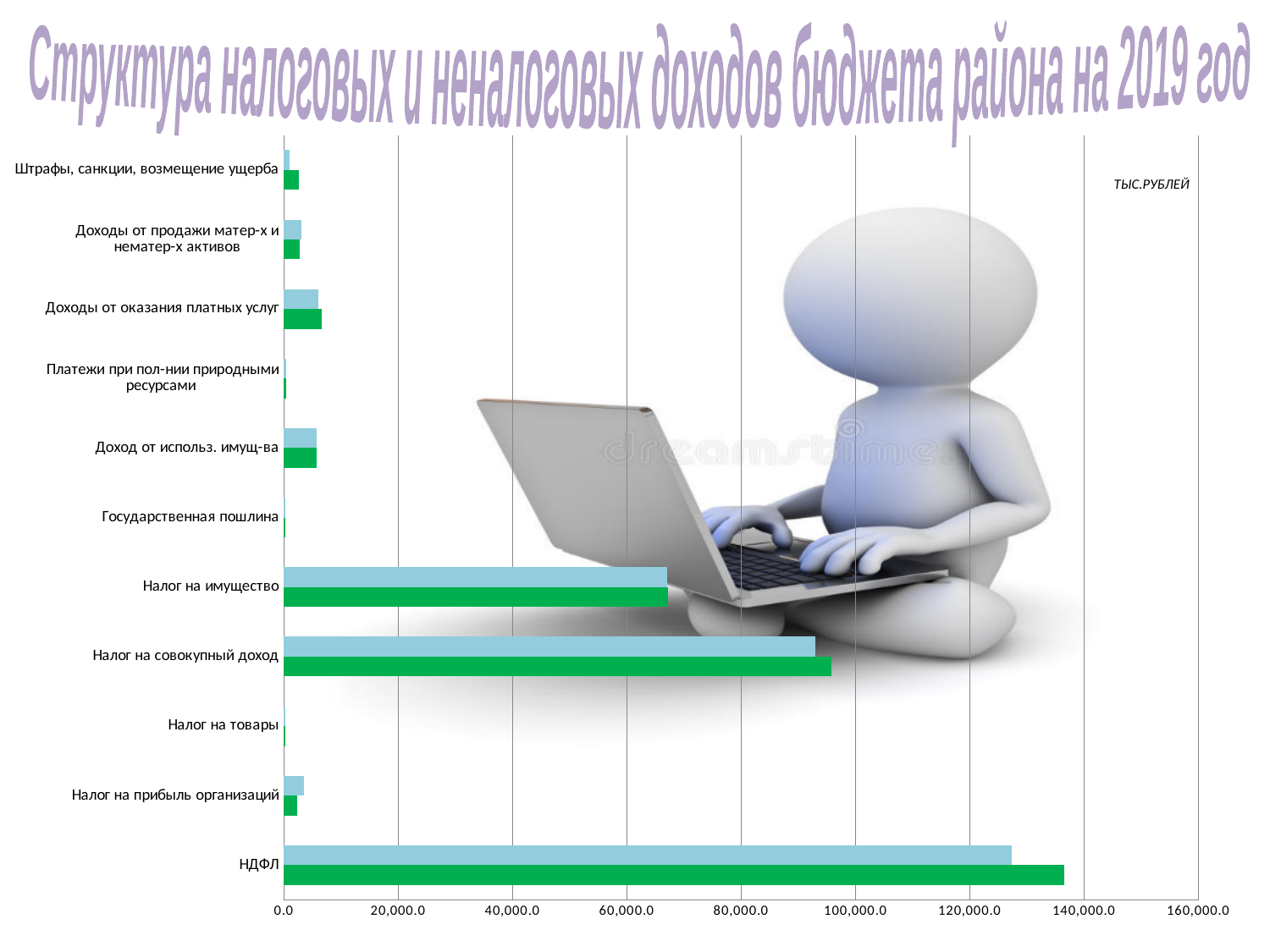
What is the title of the slide? Структура налоговых и неналоговых доходов бюджета района на 2019 год What unit is indicated in the top right corner of the chart? ТЫС.РУБЛЕЙ Is the green bar for Налог на имущество greater or less than 80,000.0? less Which category has the highest values in the chart? НДФЛ Is the light blue bar for НДФЛ greater or less than 140,000.0? less Is the light blue bar for Налог на прибыль организаций greater or less than 20,000.0? less Which has larger values, Налог на совокупный доход or Налог на имущество? Налог на совокупный доход What kind of chart is shown on the slide? bar chart How many categories are listed on the vertical axis of the chart? 11 Which has larger values, НДФЛ or Налог на совокупный доход? НДФЛ